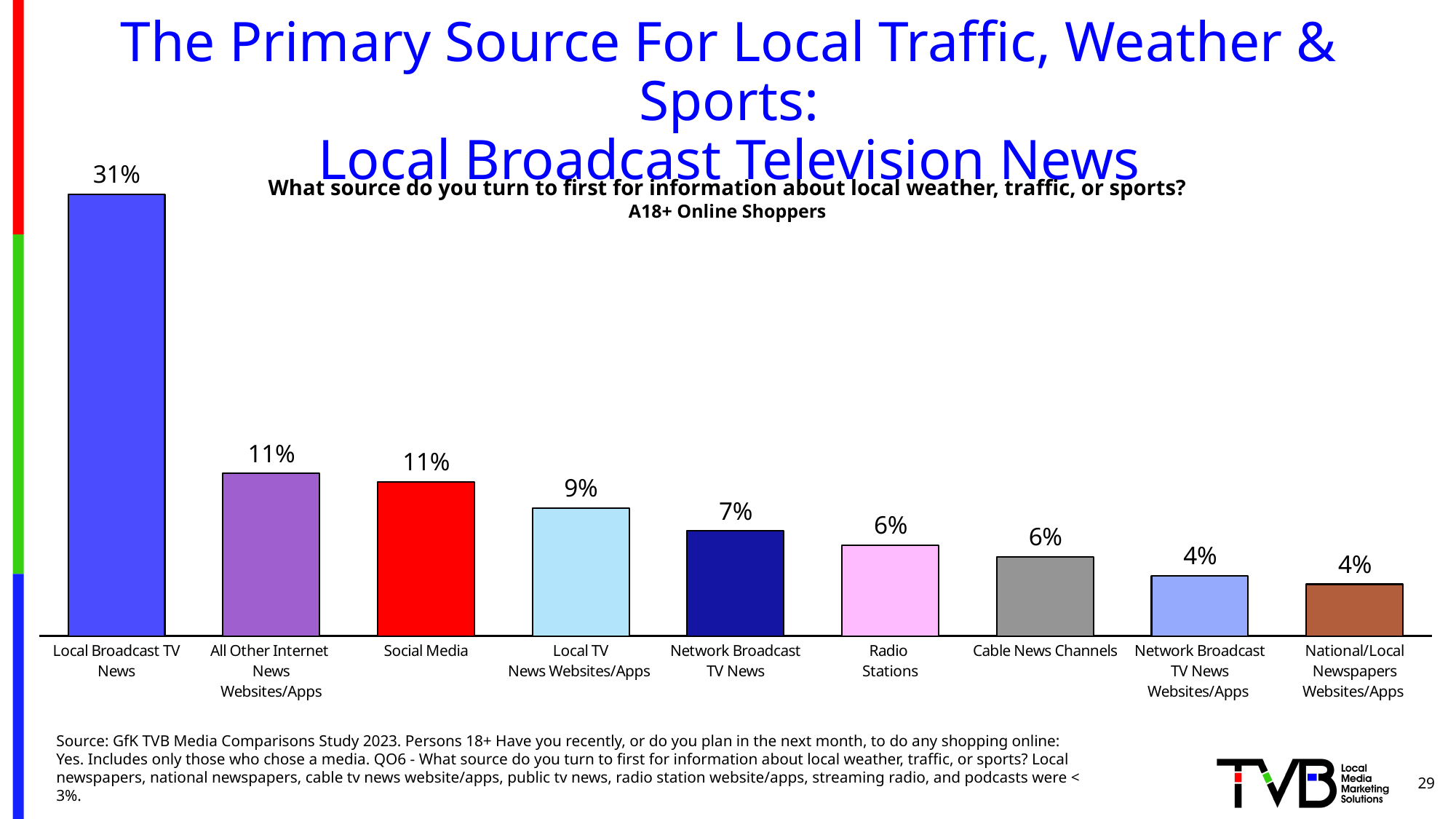
What is the difference between the values for Local Broadcast TV News and Local TV News Websites/Apps? 22% What kind of chart is shown on the slide? Bar chart What is the value shown for Network Broadcast TV News? 7% Do the values generally rise or fall moving from left to right across the chart? Fall What percentage of A18+ online shoppers turn first to Local Broadcast TV News for local weather, traffic, or sports? 31% How many sources (categories) are shown in the chart? 9 What is the value shown for Radio Stations? 6% What audience is the chart based on, according to the subtitle? A18+ Online Shoppers Which source has the highest value in the chart? Local Broadcast TV News What is the difference between the values for All Other Internet News Websites/Apps and Cable News Channels? 5% What is the value shown for Social Media? 11% Which is larger, the value for Local TV News Websites/Apps or the value for Network Broadcast TV News Websites/Apps? Local TV News Websites/Apps